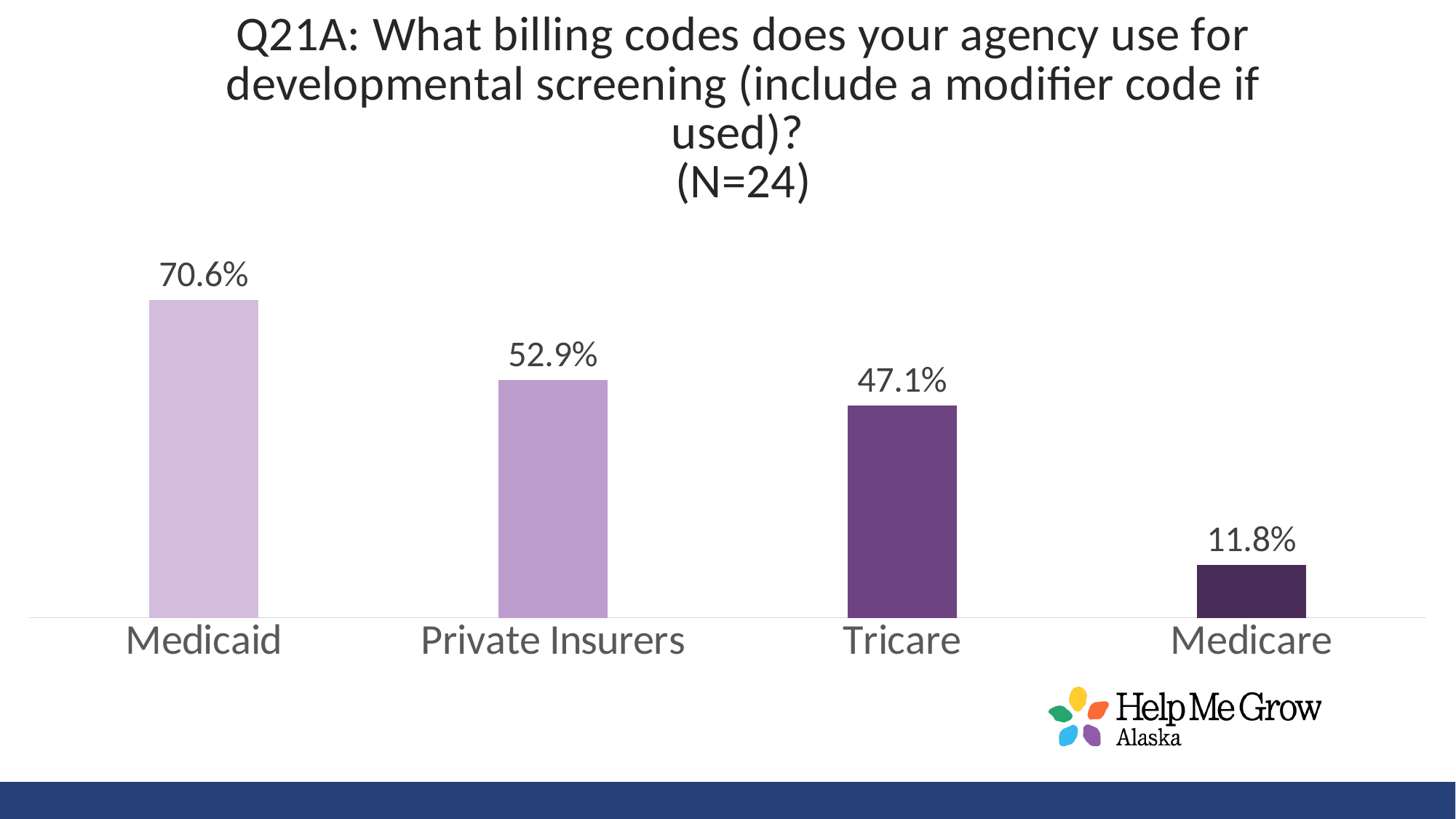
What is the value for Medicaid? 70.6% What sample size (N) is given in the chart title? N=24 What is the value for Private Insurers? 52.9% What is the difference between the values for Private Insurers and Tricare? 5.8% Which is larger, the value for Private Insurers or the value for Tricare? Private Insurers What is the value for Tricare? 47.1% What is the difference between the values for Medicaid and Medicare? 58.8% Which category has the highest value? Medicaid What is the value for Medicare? 11.8% How many categories are shown in the chart? 4 What kind of chart is shown on the slide? Bar chart Which category has the lowest value? Medicare